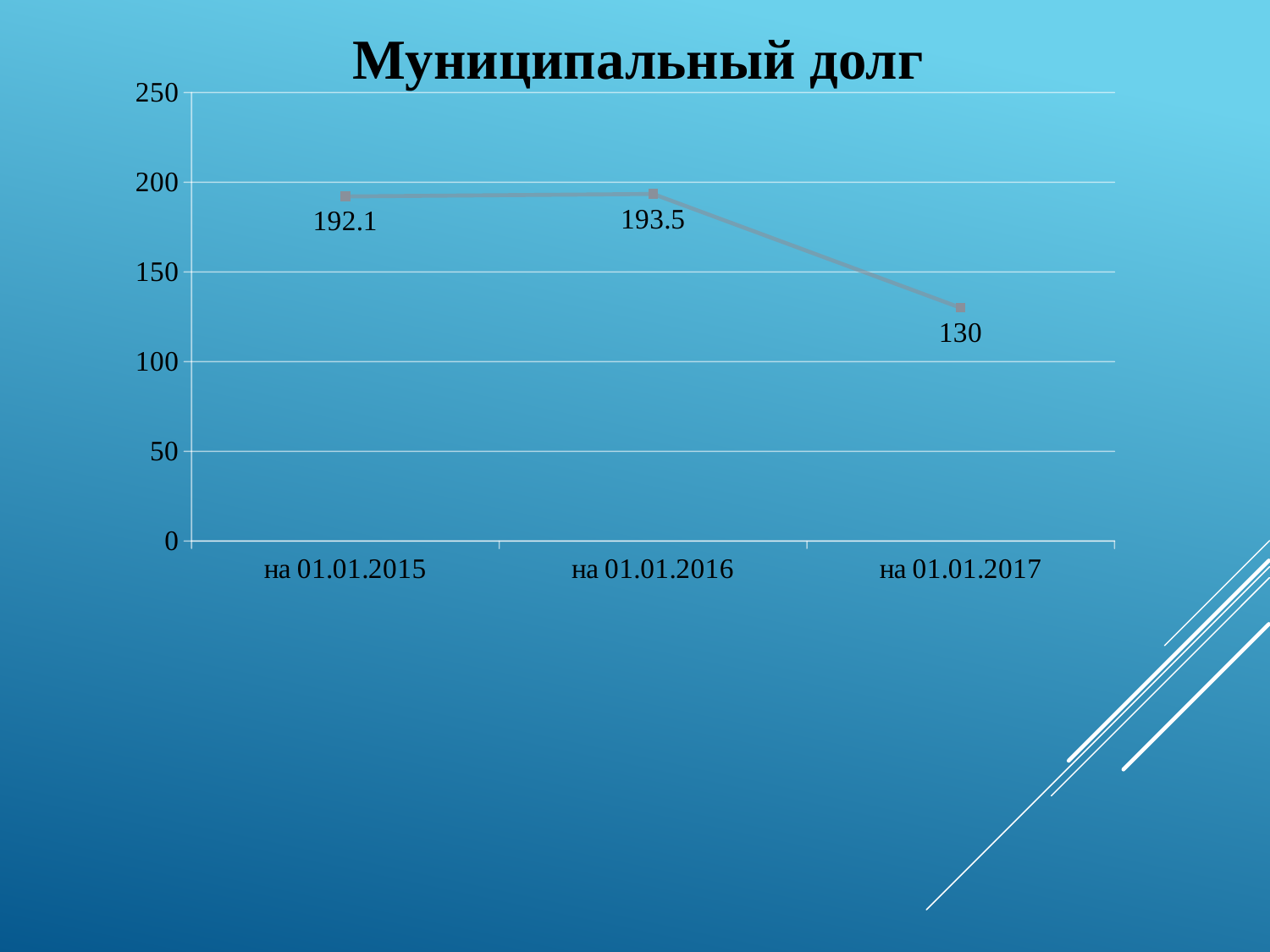
What is the value for на 01.01.2015? 192.1 What is the difference between the values for на 01.01.2016 and на 01.01.2015? 1.4 What is the value for на 01.01.2016? 193.5 Is the value for на 01.01.2017 greater or less than 150? less What is the value for на 01.01.2017? 130 How many data points are plotted on the chart? 3 Which is larger, the value for на 01.01.2015 or the value for на 01.01.2017? на 01.01.2015 What is the title of the chart? Муниципальный долг Which date has the lowest value? на 01.01.2017 What kind of chart is shown on the slide? line chart Which date has the highest value? на 01.01.2016 What is the difference between the values for на 01.01.2016 and на 01.01.2017? 63.5